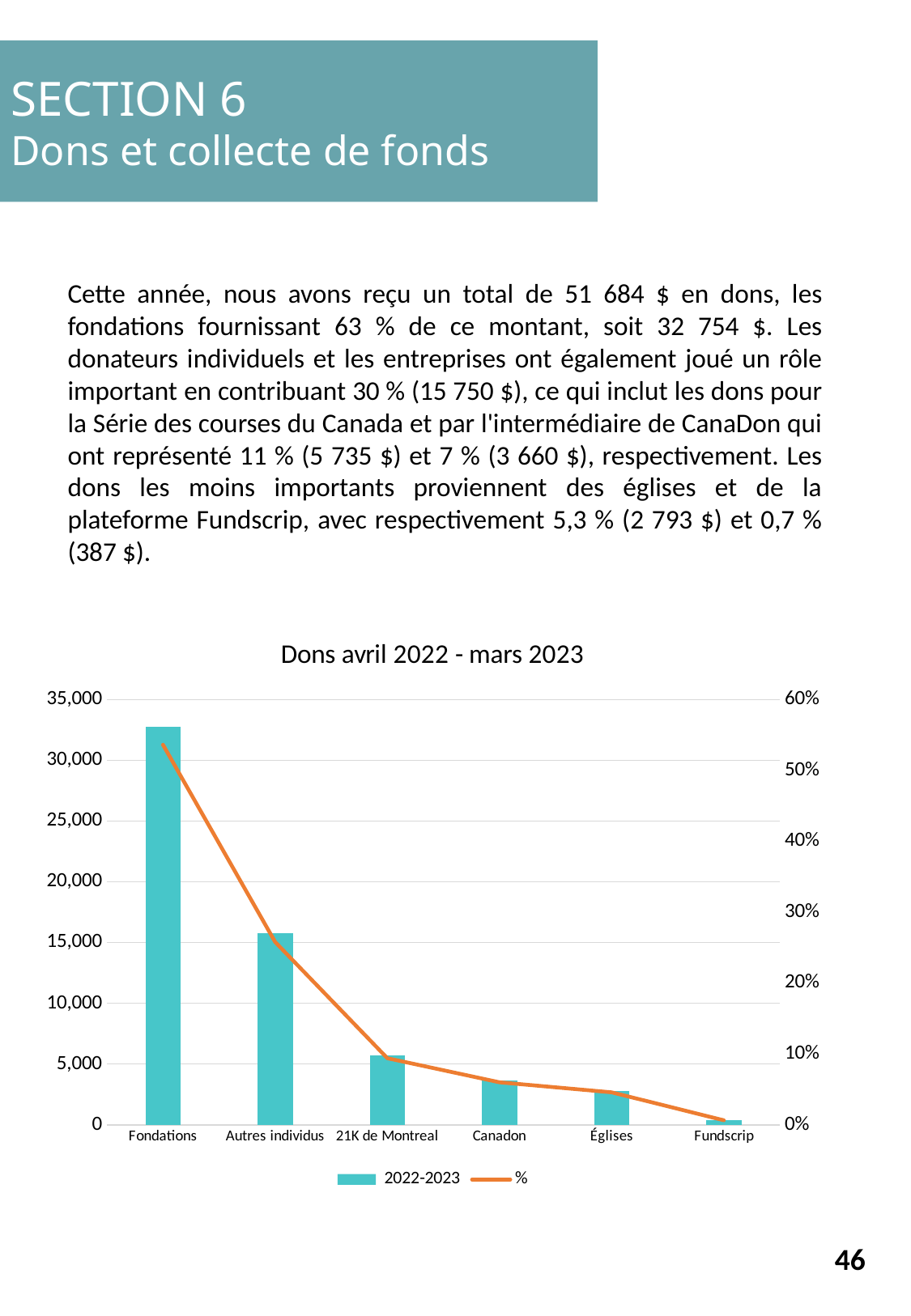
How many series does the chart legend list? 2 Is the 2022-2023 bar for 21K de Montreal greater or less than 10,000? less Which has a larger 2022-2023 bar, Autres individus or Églises? Autres individus Is the 2022-2023 bar for Canadon greater or less than 5,000? less Which category has the lowest bar in the chart? Fundscrip Which category has the highest bar in the chart? Fondations Do the bar values rise or fall moving from left to right along the x axis? fall Is the 2022-2023 bar for Fondations greater or less than 30,000? greater What is the title of the chart? Dons avril 2022 - mars 2023 How many categories are shown on the x axis of the chart? 6 What type of chart is shown on the slide? bar chart with a line